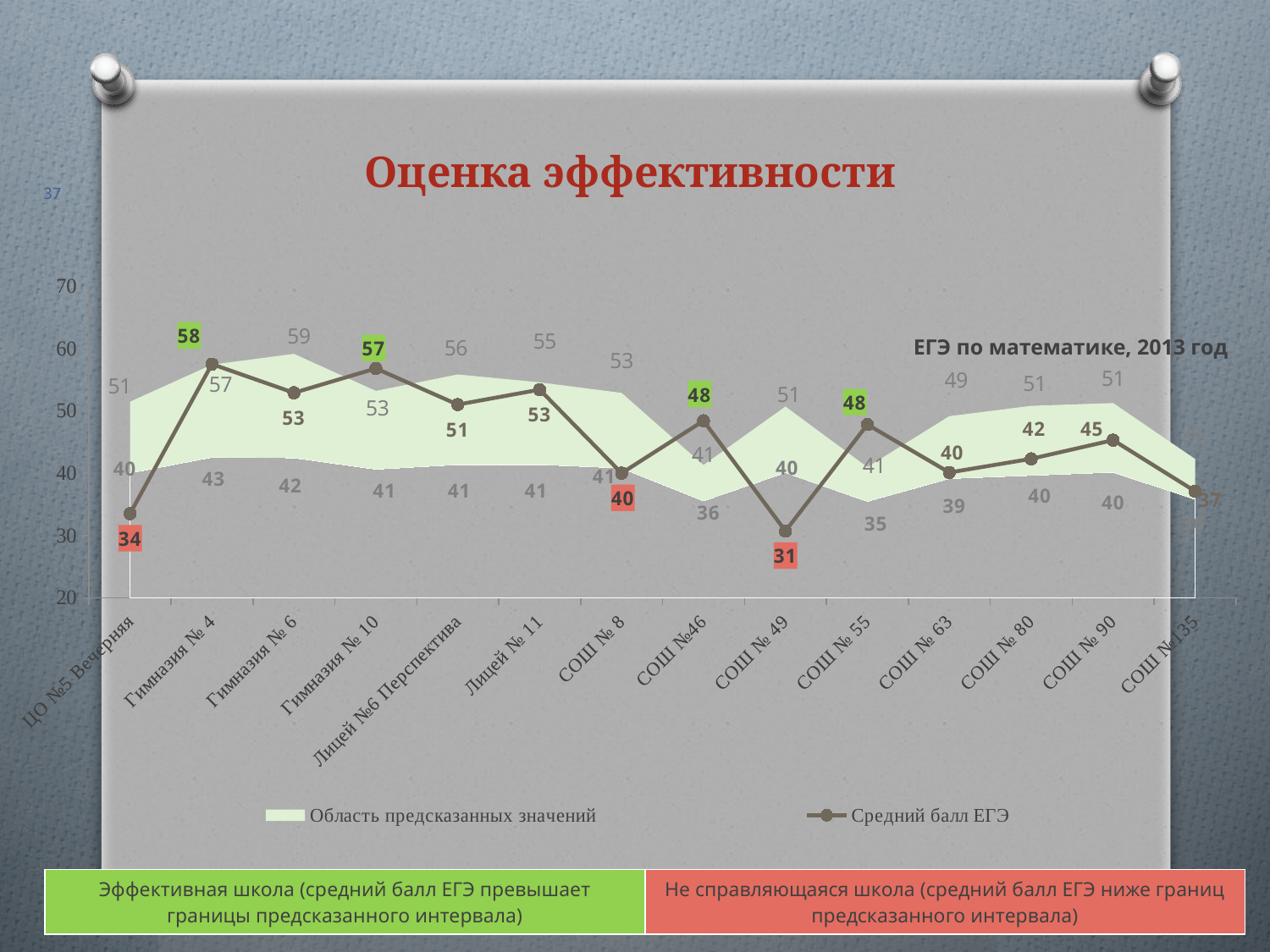
What is the difference between the average ЕГЭ scores of Гимназия № 4 and ЦО №5 Вечерняя? 24 How many schools are shown along the x axis of the chart? 14 What is the average ЕГЭ score for СОШ №135? 37 What is the difference between the average ЕГЭ scores of СОШ № 90 and СОШ № 80? 3 Which has a higher average ЕГЭ score, Гимназия № 10 or Лицей № 11? Гимназия № 10 What is the average ЕГЭ score (Средний балл ЕГЭ) for Гимназия № 4? 58 What is the average ЕГЭ score for СОШ № 90? 45 Which school has the highest average ЕГЭ score on the chart? Гимназия № 4 What subject and year does the chart's label say the ЕГЭ data refers to? ЕГЭ по математике, 2013 год Which school has the lowest average ЕГЭ score on the chart? СОШ № 49 How many series does the chart legend list? 2 What is the average ЕГЭ score for СОШ № 49? 31